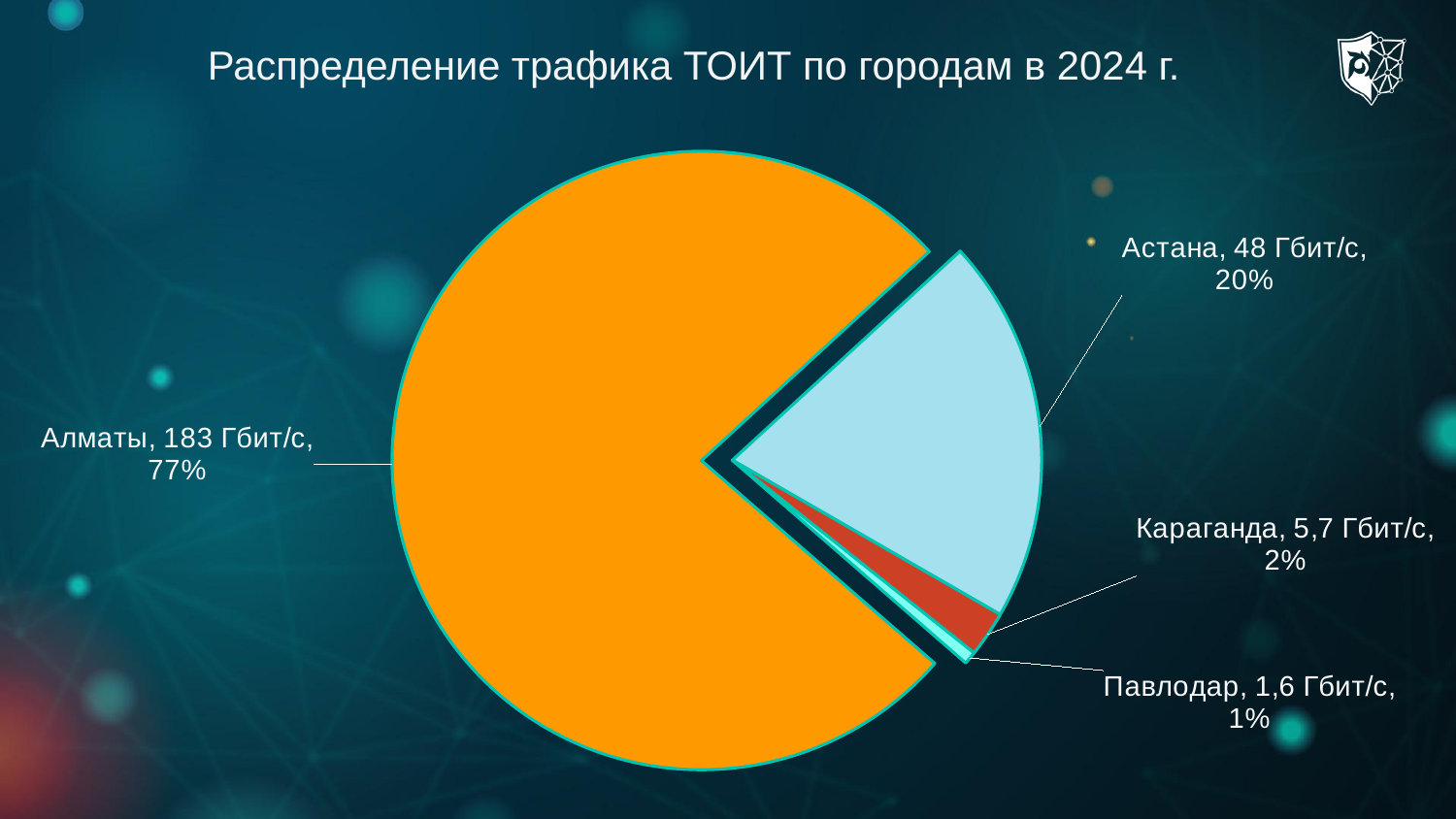
What kind of chart is shown on the slide? pie chart Which city has the largest share of traffic? Алматы What is the traffic value for Алматы? 183 Гбит/с Which city has the smallest share of traffic? Павлодар What share of the pie does Караганда account for? 2% What is the title of the chart? Распределение трафика ТОИТ по городам в 2024 г. What is the traffic value for Караганда? 5,7 Гбит/с What share of the pie does Астана account for? 20% How many cities (slices) are shown in the pie chart? 4 What is the traffic value for Павлодар? 1,6 Гбит/с What is the traffic value for Астана? 48 Гбит/с Which has more traffic, Астана or Караганда? Астана